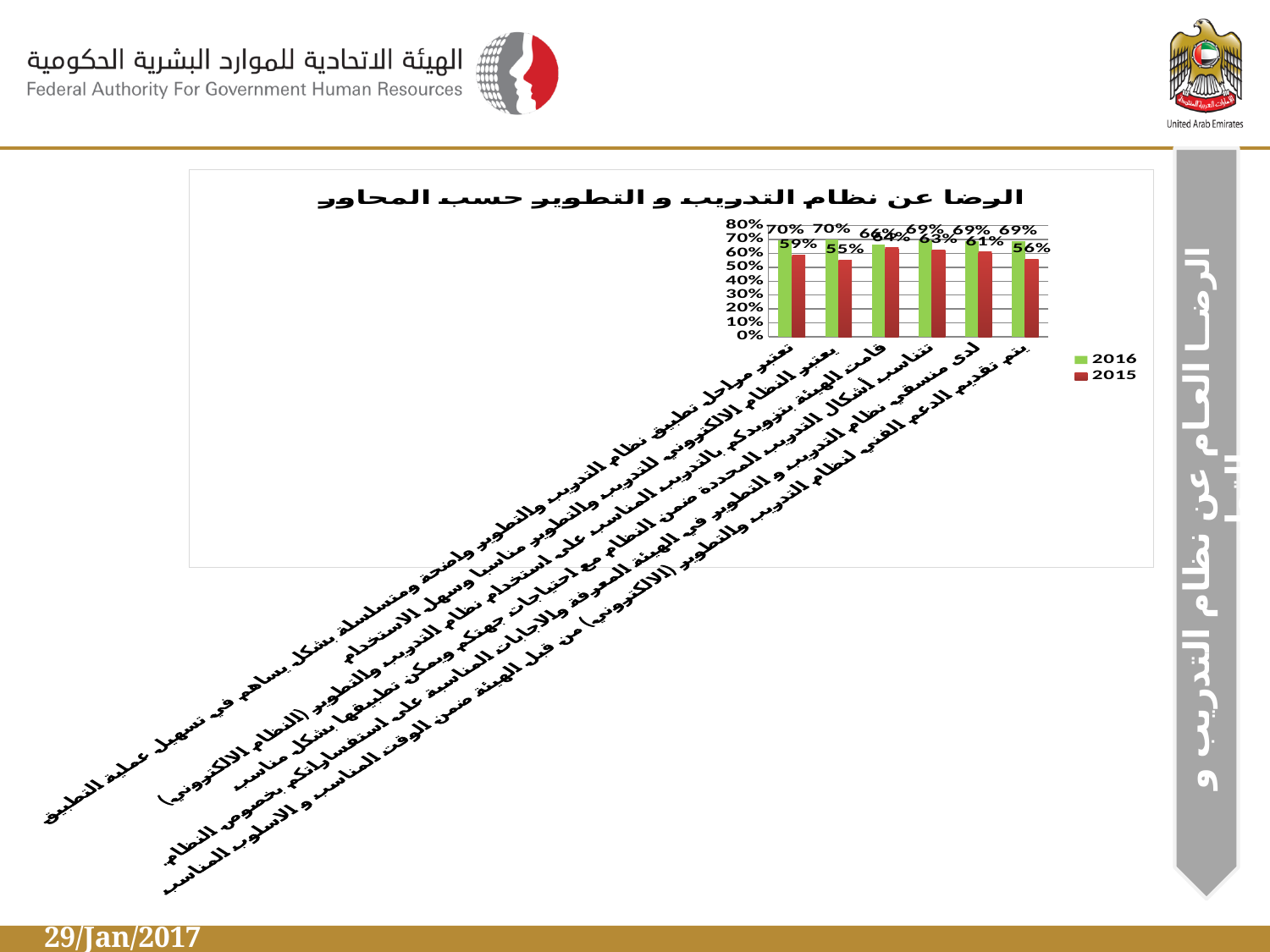
For the rightmost category, which year has the higher value, 2016 or 2015? 2016 What is the 2015 value for the second category from the left? 55% What is the 2015 value for the rightmost category in the chart? 56% Is the 2015 value for the rightmost category greater or less than 60%? less What is the 2016 value for the leftmost category in the chart? 70% How many categories are plotted along the x axis of the chart? 6 What kind of chart is shown on the slide? Bar chart How many series does the chart legend list? 2 Which category has the lowest 2015 value? The second category from the left (55%) Which years are listed in the chart legend? 2016 and 2015 What is the difference between the 2016 and 2015 values for the leftmost category? 11 percentage points What is the 2015 value for the leftmost category in the chart? 59%